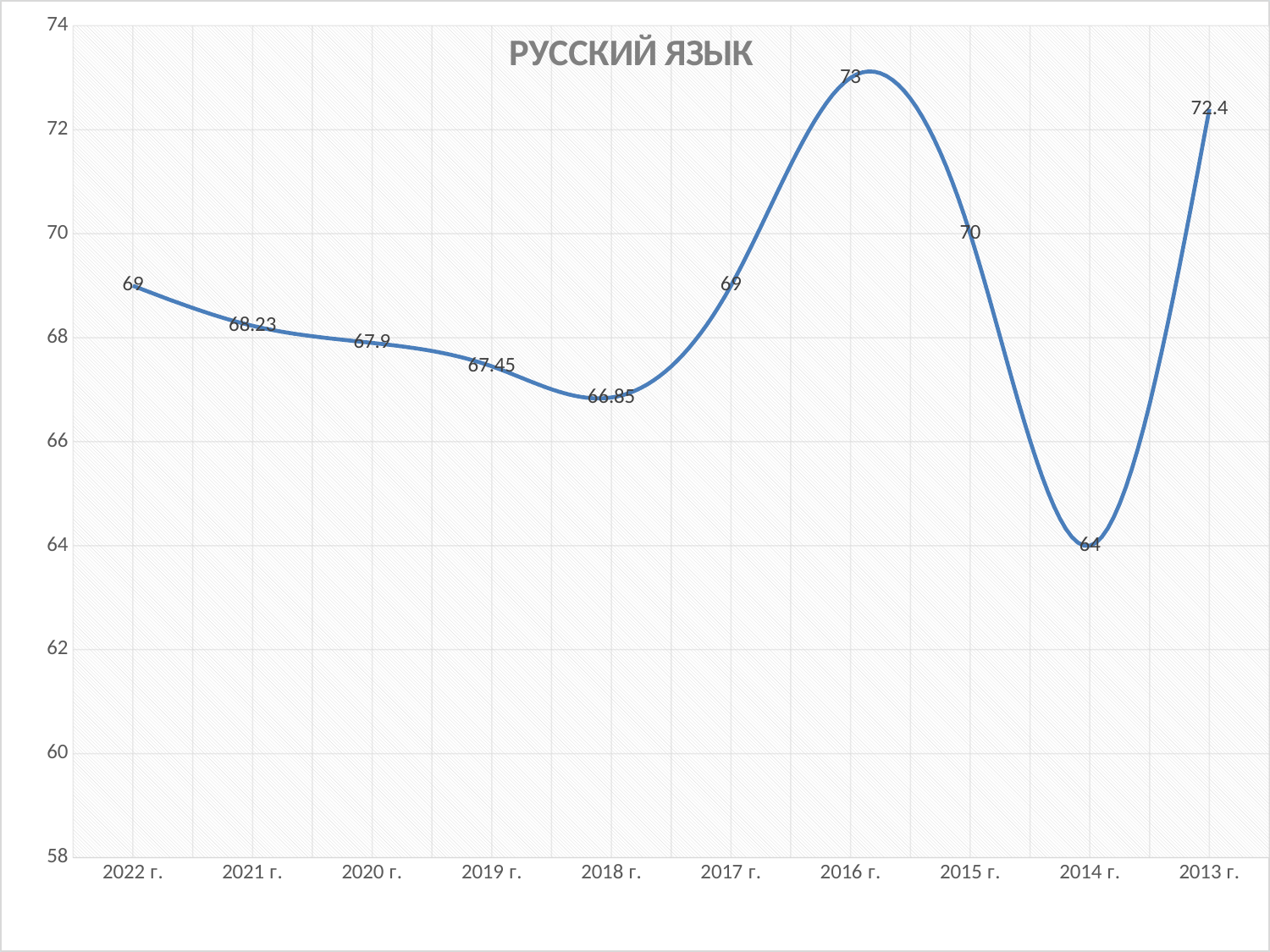
Which year has the lowest value? 2014 г. Which year has the highest value? 2016 г. Is the value for 2019 г. greater or less than 68? less What is the difference between the values for 2022 г. and 2018 г.? 2.15 What kind of chart is shown? line chart How many years are plotted on the chart? 10 What is the value for 2021 г.? 68.23 What is the value for 2018 г.? 66.85 Which is larger, the value for 2015 г. or the value for 2013 г.? 2013 г. What is the difference between the values for 2016 г. and 2014 г.? 9 What is the value for 2013 г.? 72.4 What is the title of the chart? РУССКИЙ ЯЗЫК